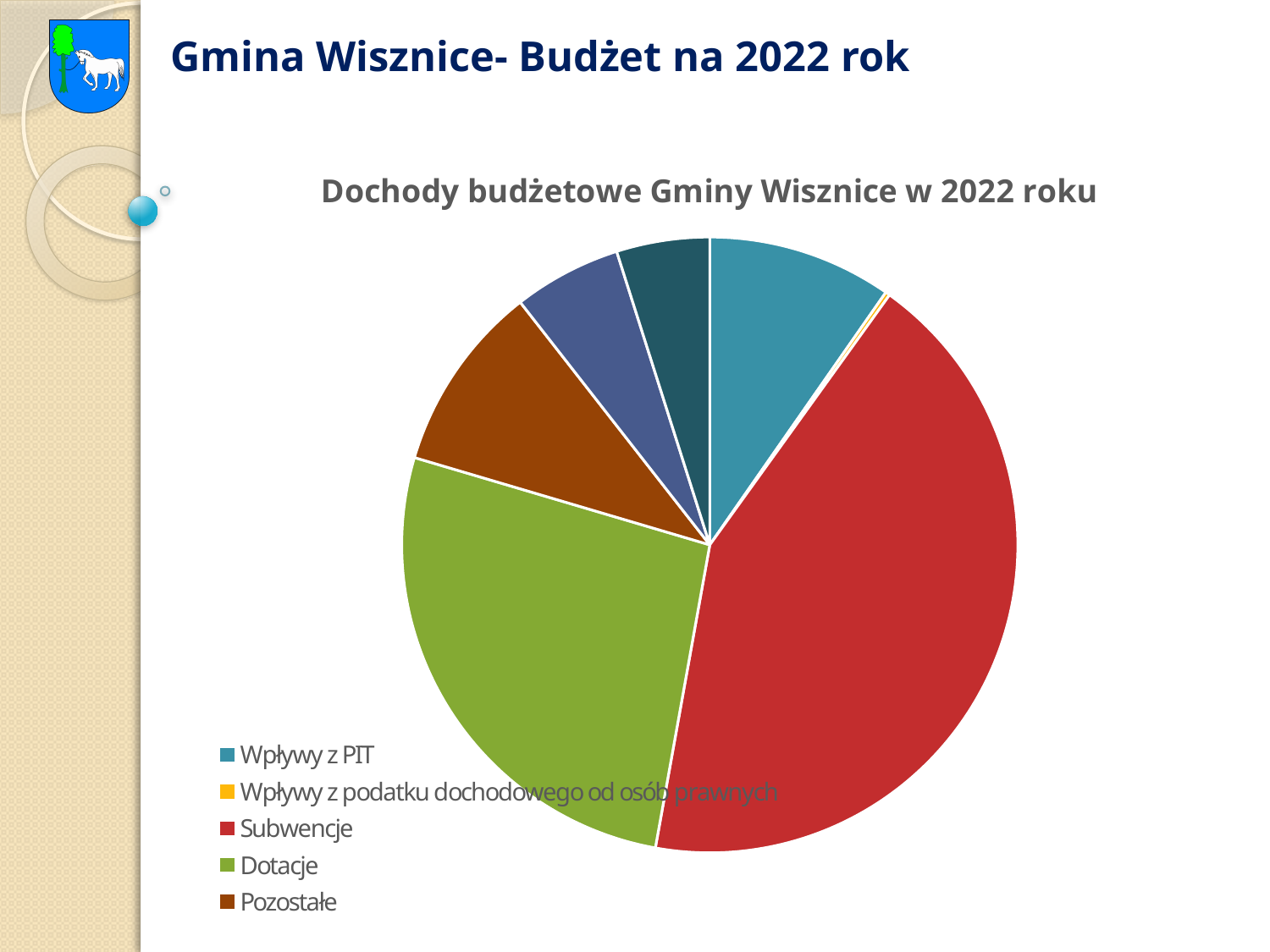
Which is larger, the slice for Dotacje or the slice for Pozostałe? Dotacje How many slices does the pie chart have? 7 Which category has the largest slice of the pie? Subwencje What is the title of the chart? Dochody budżetowe Gminy Wisznice w 2022 roku Which legend category has the smallest slice of the pie? Wpływy z podatku dochodowego od osób prawnych Which is larger, the slice for Subwencje or the slice for Dotacje? Subwencje How many entries does the chart legend list? 5 Which is larger, the slice for Subwencje or the slice for Wpływy z PIT? Subwencje What kind of chart is shown on the slide? pie chart What colour is the slice for Subwencje? red